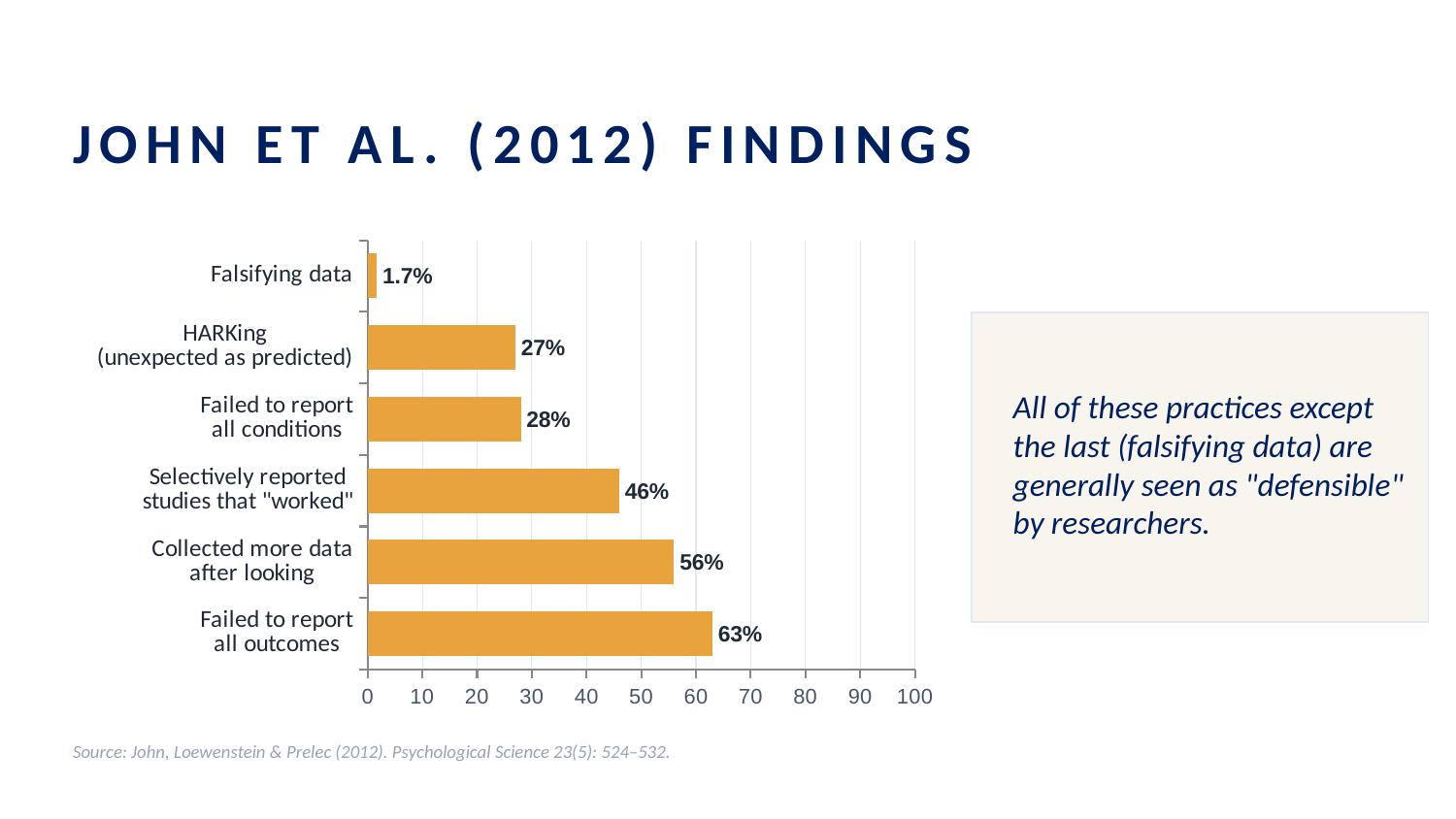
Which category has the highest value? Failed to report all outcomes What kind of chart is shown on the slide? Bar chart What is the value for "Failed to report all outcomes"? 63% What is the value for "Collected more data after looking"? 56% What is the value for "HARKing (unexpected as predicted)"? 27% Which is larger, the value for "Selectively reported studies that "worked"" or the value for "Failed to report all conditions"? Selectively reported studies that "worked" What is the title of the slide containing the chart? JOHN ET AL. (2012) FINDINGS Is the value for "Selectively reported studies that "worked"" greater or less than 50? less How many categories are shown in the chart? 6 What is the value for "Falsifying data"? 1.7% What is the difference between the values for "Failed to report all outcomes" and "Collected more data after looking"? 7% Which category has the lowest value? Falsifying data